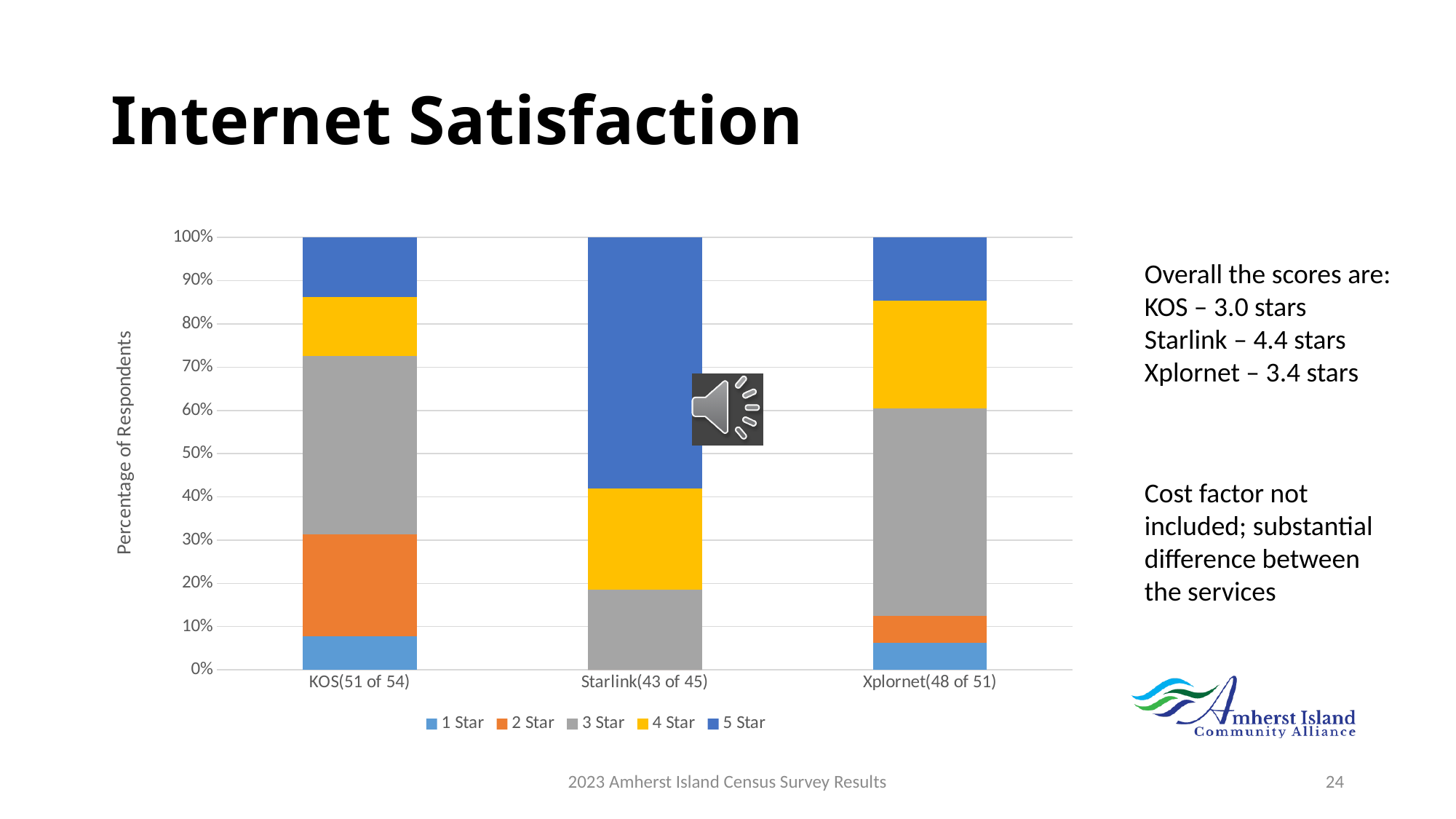
Which provider has the largest 2 Star share? KOS(51 of 54) What kind of chart is shown on the slide? Stacked bar chart Which has a larger 4 Star share, KOS(51 of 54) or Xplornet(48 of 51)? Xplornet(48 of 51) Which provider has the largest 5 Star share? Starlink(43 of 45) Is the 1 Star share for Xplornet(48 of 51) greater or less than 10%? less How many series does the legend list? 5 Is the 3 Star share for Starlink(43 of 45) greater or less than 30%? less Is the 3 Star share for Xplornet(48 of 51) greater or less than 40%? greater What does each stacked bar total on the y axis? 100% How many internet providers (categories) are shown on the x axis? 3 What is the title of the y axis? Percentage of Respondents